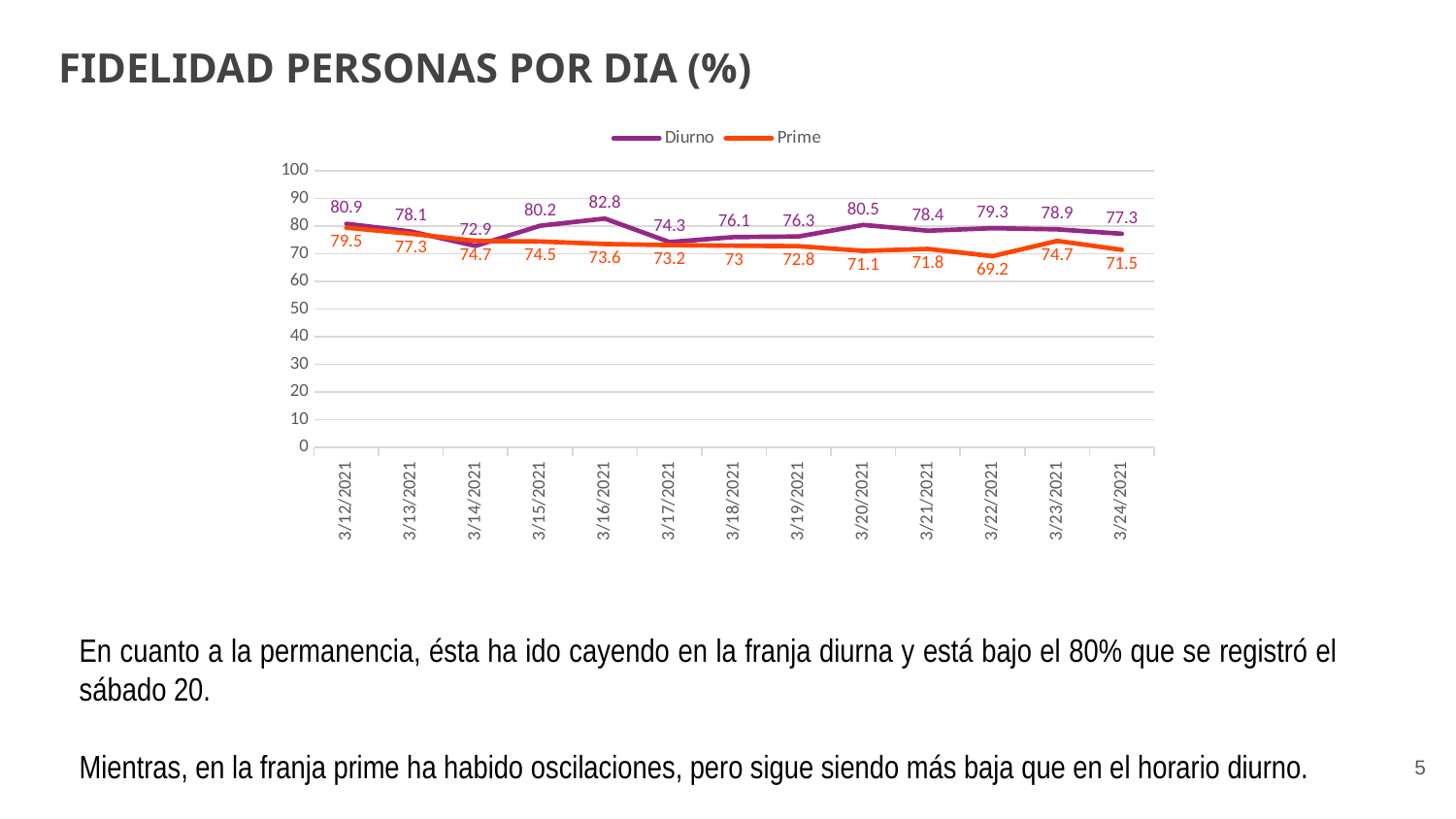
On 3/14/2021, which series has the higher value, Diurno or Prime? Prime On which date does the Prime series reach its lowest value? 3/22/2021 What kind of chart is shown on the slide? Line chart How many dates are plotted on the x axis? 13 Does the Prime series rise or fall from 3/12/2021 to 3/24/2021? Fall On which date does the Diurno series reach its highest value? 3/16/2021 What is the difference between the Diurno and Prime values on 3/20/2021? 9.4 What is the Diurno value on 3/16/2021? 82.8 On which date does the Diurno series reach its lowest value? 3/14/2021 What colour is the Prime line in the chart? Orange How many series does the legend list? 2 What is the Prime value on 3/22/2021? 69.2